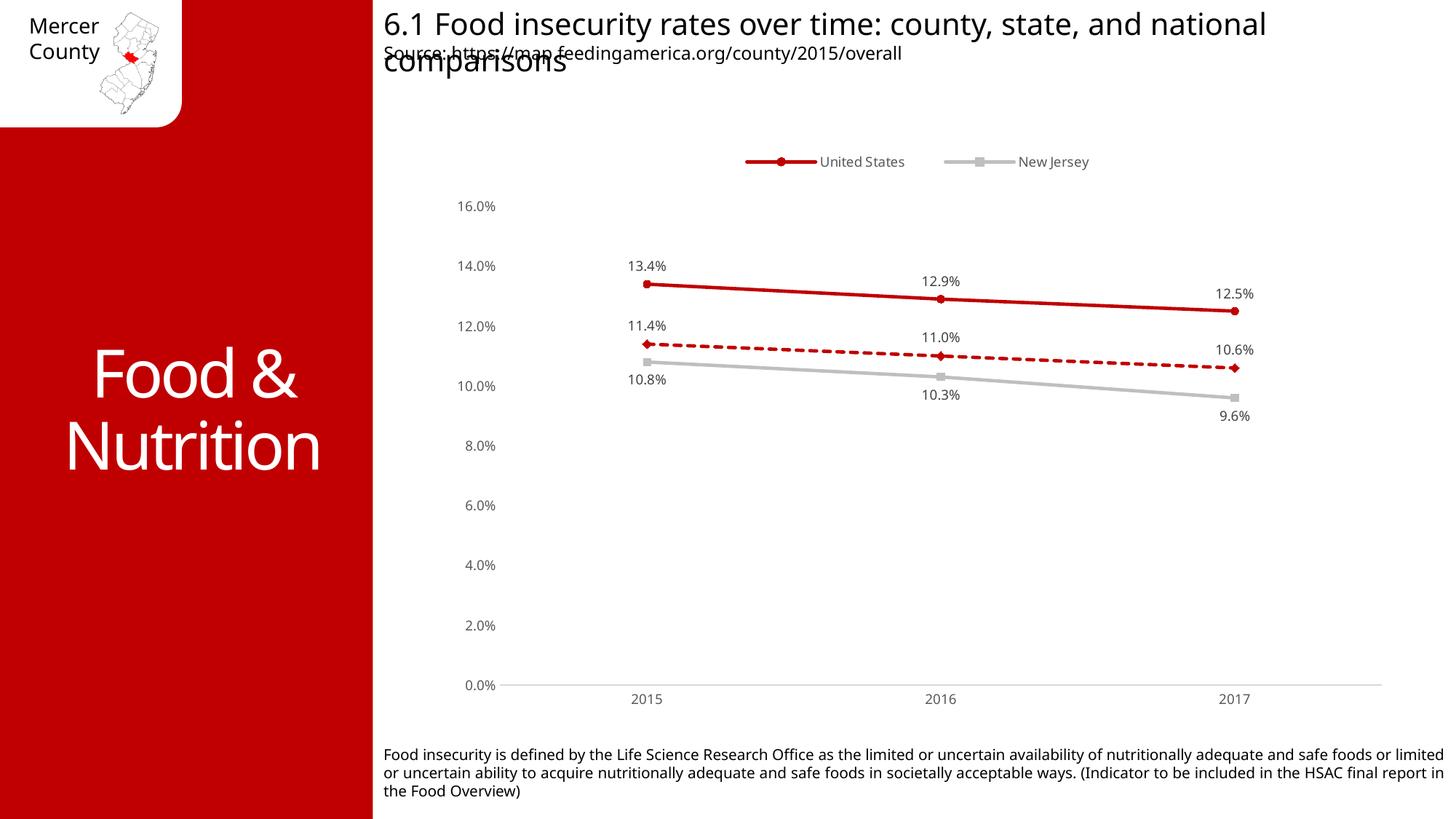
How many years are shown on the x axis? 3 In which year is the United States food insecurity rate highest? 2015 In 2017, which has the higher food insecurity rate, the United States or New Jersey? United States What is the food insecurity rate for the United States in 2015? 13.4% What is the food insecurity rate for the United States in 2016? 12.9% How many series does the legend list? 2 Is the value for New Jersey in 2015 greater or less than 12.0%? less What is the food insecurity rate for New Jersey in 2016? 10.3% What is the food insecurity rate for New Jersey in 2017? 9.6% In which year is the New Jersey food insecurity rate lowest? 2017 By how much did the United States food insecurity rate fall from 2015 to 2017? 0.9% What kind of chart is shown on the slide? line chart